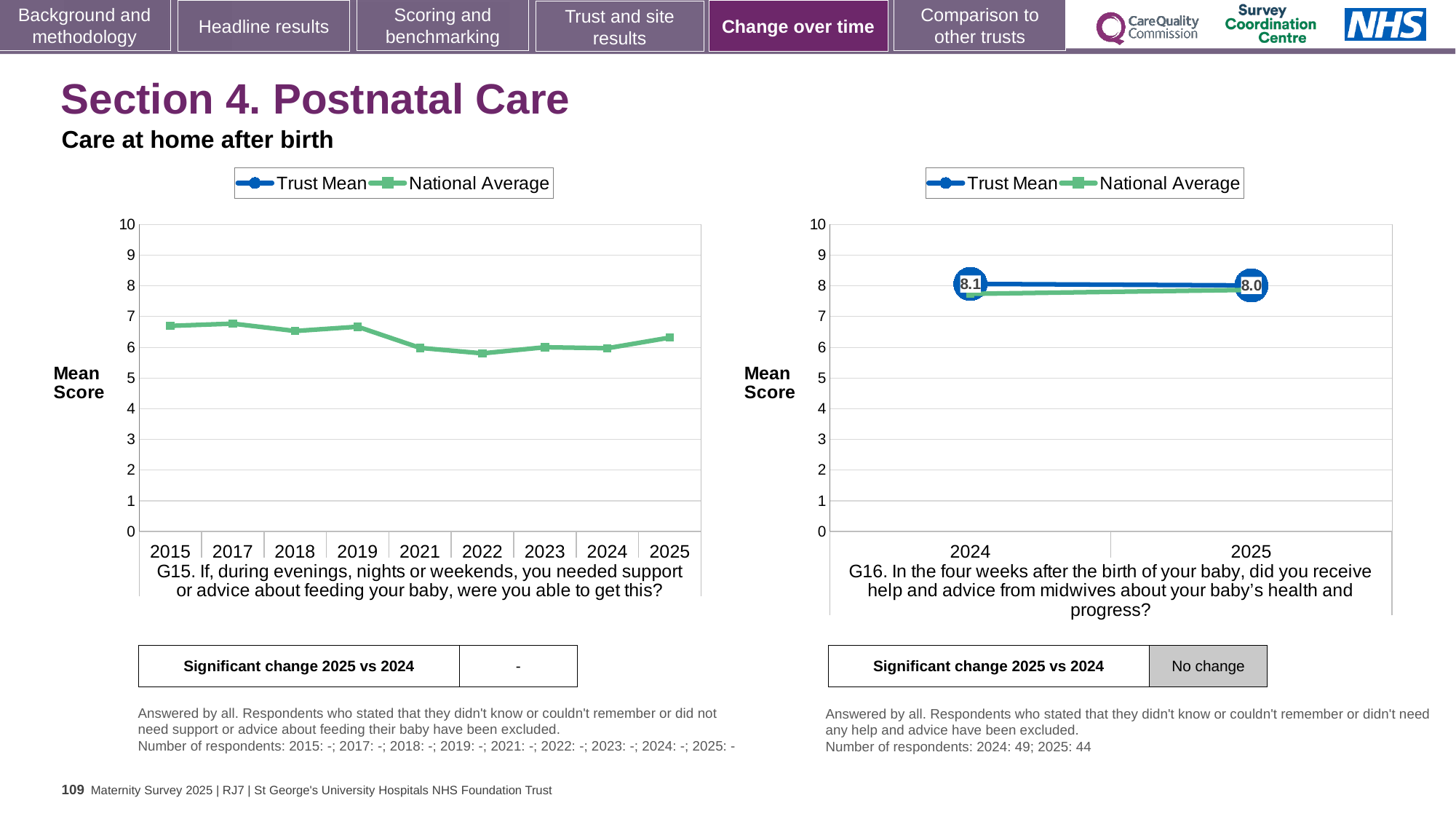
On the right chart (G16), what is the Trust Mean score for 2025? 8.0 On the right chart (G16), which year has the higher Trust Mean score, 2024 or 2025? 2024 On the left chart (G15), how many years are shown on the x axis? 9 On the right chart (G16), what is the Trust Mean score for 2024? 8.1 What kind of chart is the left chart (G15)? line chart On the right chart (G16), how many years are shown on the x axis? 2 On the right chart (G16), what is the result shown for 'Significant change 2025 vs 2024'? No change On the right chart (G16), what is the difference between the Trust Mean scores for 2024 and 2025? 0.1 On the right chart (G16), is the National Average value for 2024 greater or less than 8? less On the left chart (G15), how many series does the legend list? 2 On the left chart (G15), does the National Average rise or fall from 2015 to 2022? fall On the left chart (G15), is the National Average value for 2015 greater or less than 6? greater